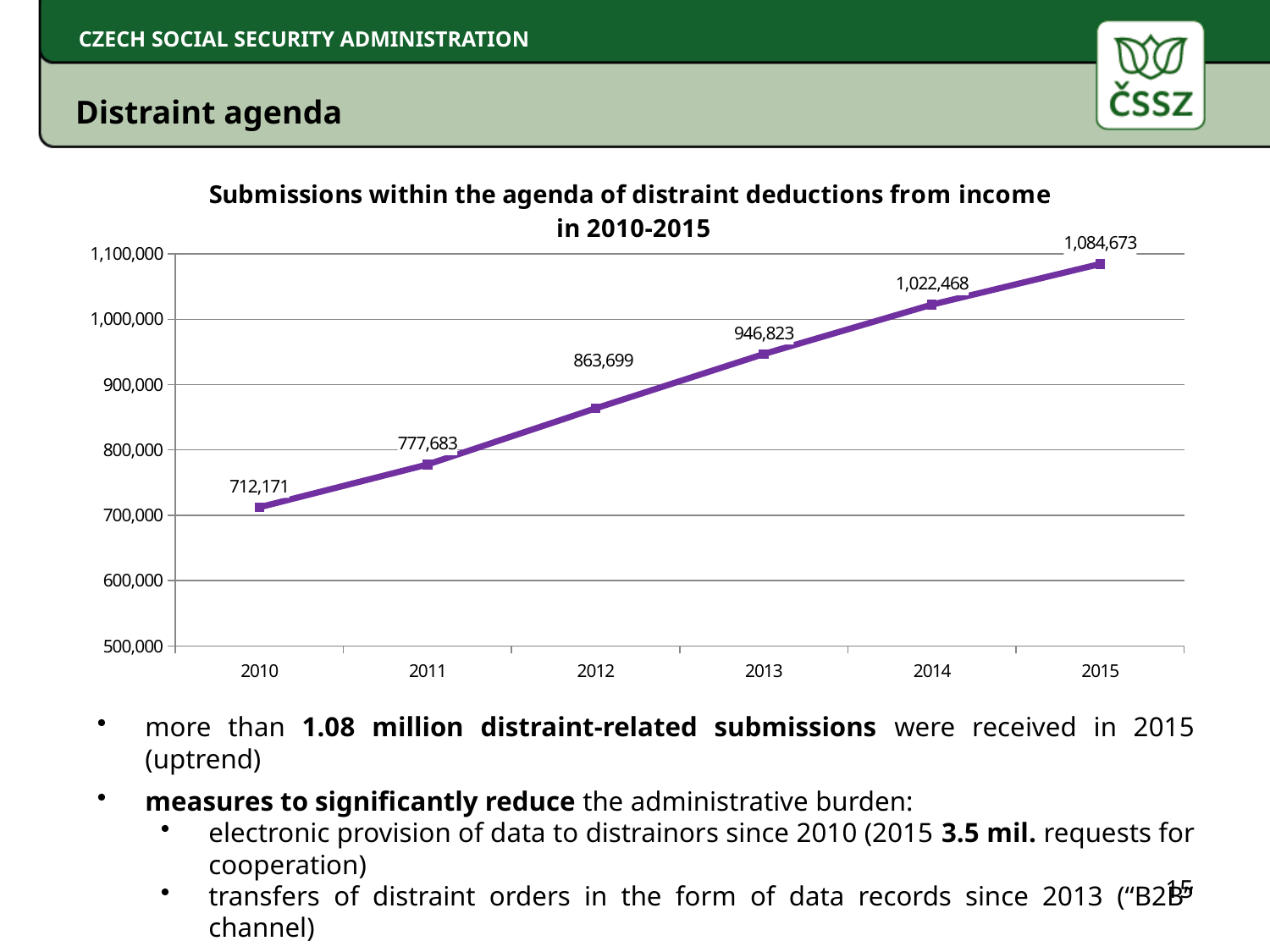
What is the value for 2015? 1,084,673 Do the values rise or fall from 2010 to 2015? rise How many years are plotted on the chart? 6 What is the difference between the values for 2015 and 2014? 62,205 Which is larger, the value for 2012 or the value for 2013? 2013 What is the value for 2010? 712,171 What kind of chart is shown? line chart What is the value for 2013? 946,823 Which year has the lowest value? 2010 What is the difference between the values for 2011 and 2010? 65,512 Which year has the highest value? 2015 Is the value for 2014 greater or less than 1,000,000? greater